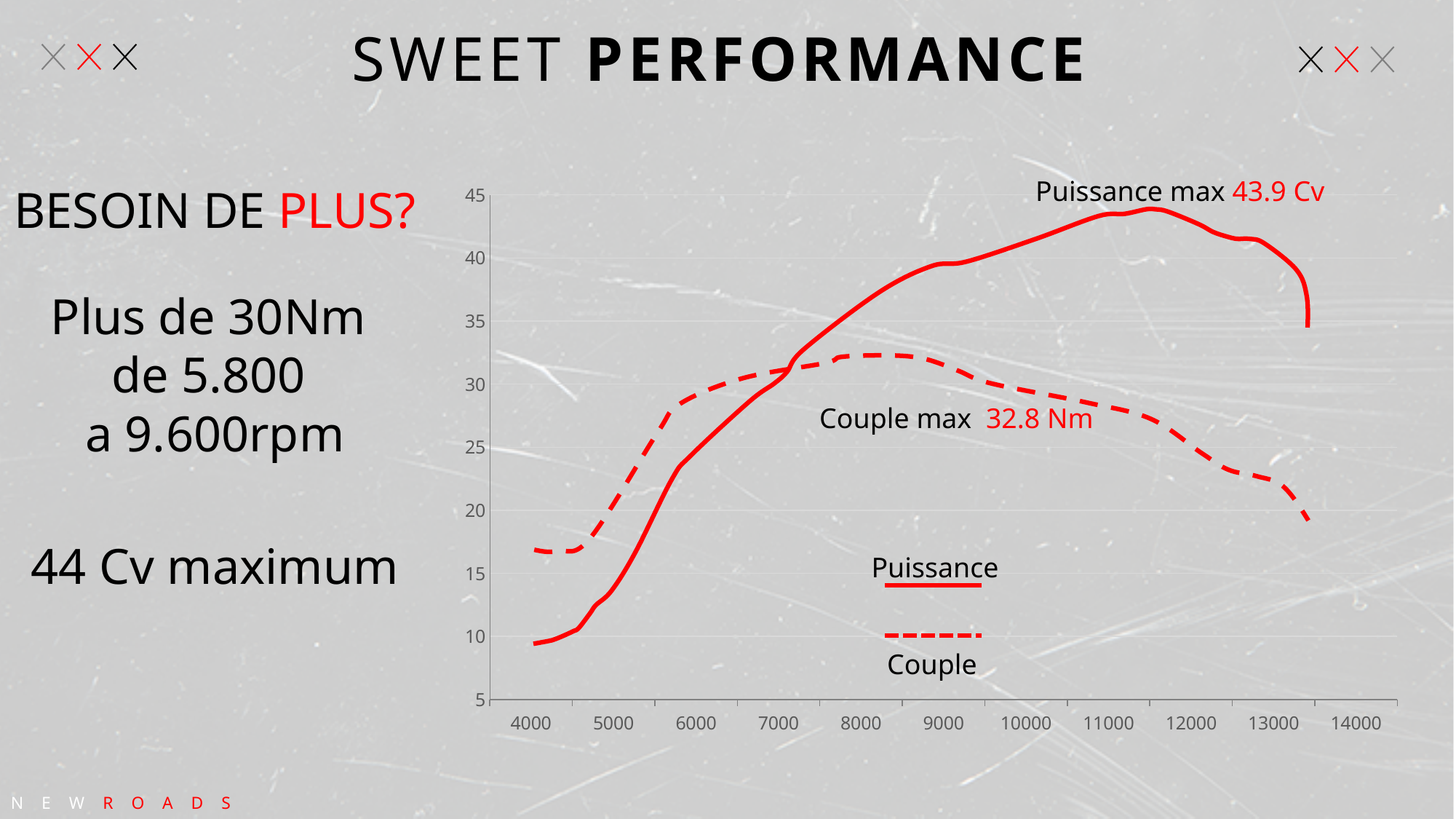
Which series is drawn with a dashed line? Couple Is the value of the Puissance series at 8000 greater or less than 35? greater What kind of chart is shown on the slide? line chart At 5000 on the x axis, which series has the higher value, Puissance or Couple? Couple Is the value of the Couple series at 6000 greater or less than 25? greater Is the value of the Puissance series at 5000 greater or less than 15? less How many series does the chart's legend list? 2 Does the Puissance series rise or fall between 4000 and 9000 on the x axis? rise What is the maximum value of the Puissance series, as annotated on the chart? 43.9 Cv Does the Couple series rise or fall between 9000 and 13000 on the x axis? fall At 12000 on the x axis, which series has the higher value, Puissance or Couple? Puissance What is the maximum value of the Couple series, as annotated on the chart? 32.8 Nm